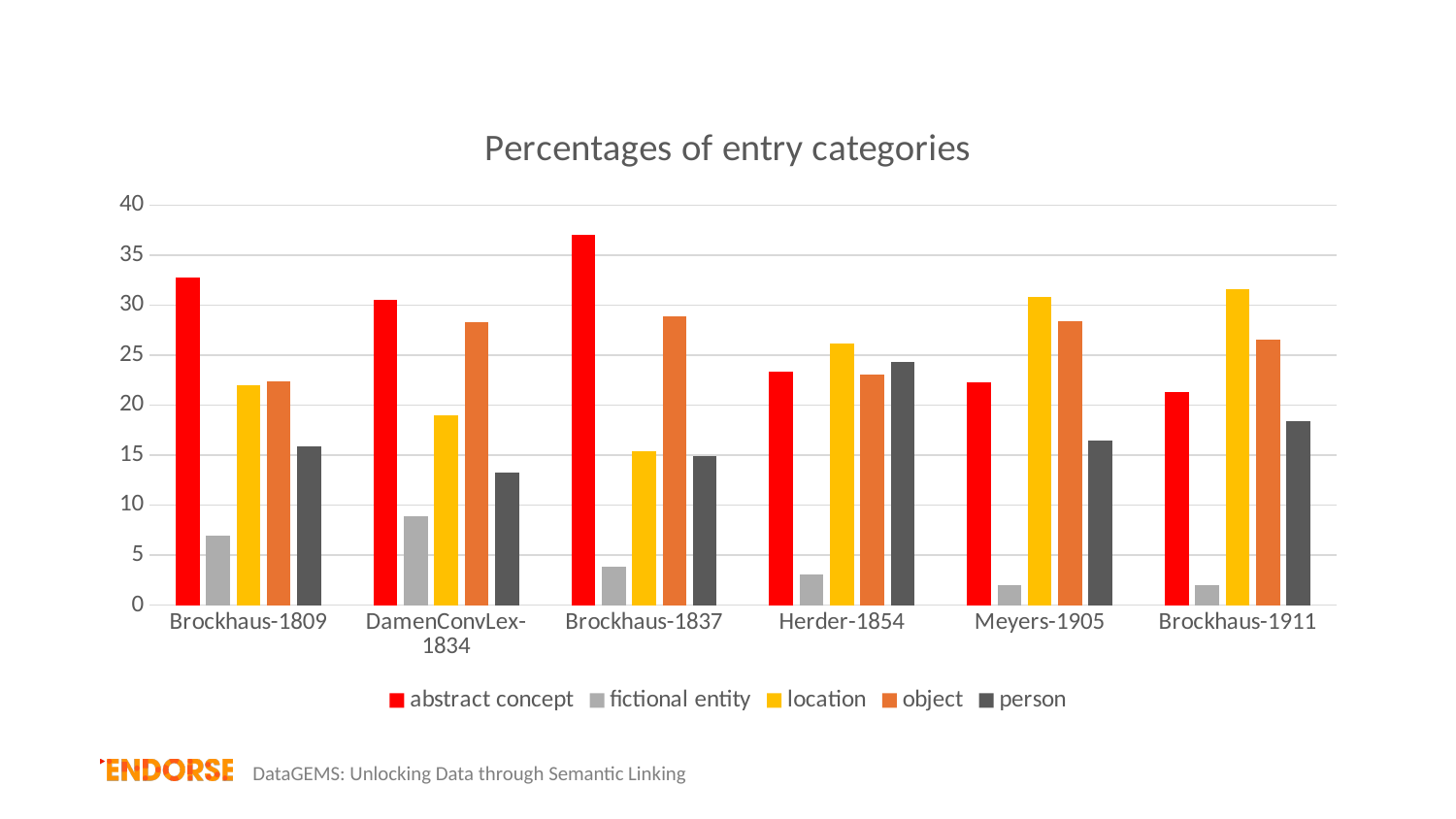
Is the location value for Brockhaus-1837 greater or less than 20? less Which edition has the highest value for person? Herder-1854 How many encyclopedia editions (categories) are shown on the x axis? 6 Is the person value for Herder-1854 greater or less than 20? greater What is the title of the chart? Percentages of entry categories Which edition has the highest value for fictional entity? DamenConvLex-1834 Is the fictional entity value for Brockhaus-1809 greater or less than 5? greater What type of chart is shown on the slide? bar chart For Meyers-1905, which is larger: location or abstract concept? location Which edition has the highest value for abstract concept? Brockhaus-1837 How many series does the legend list? 5